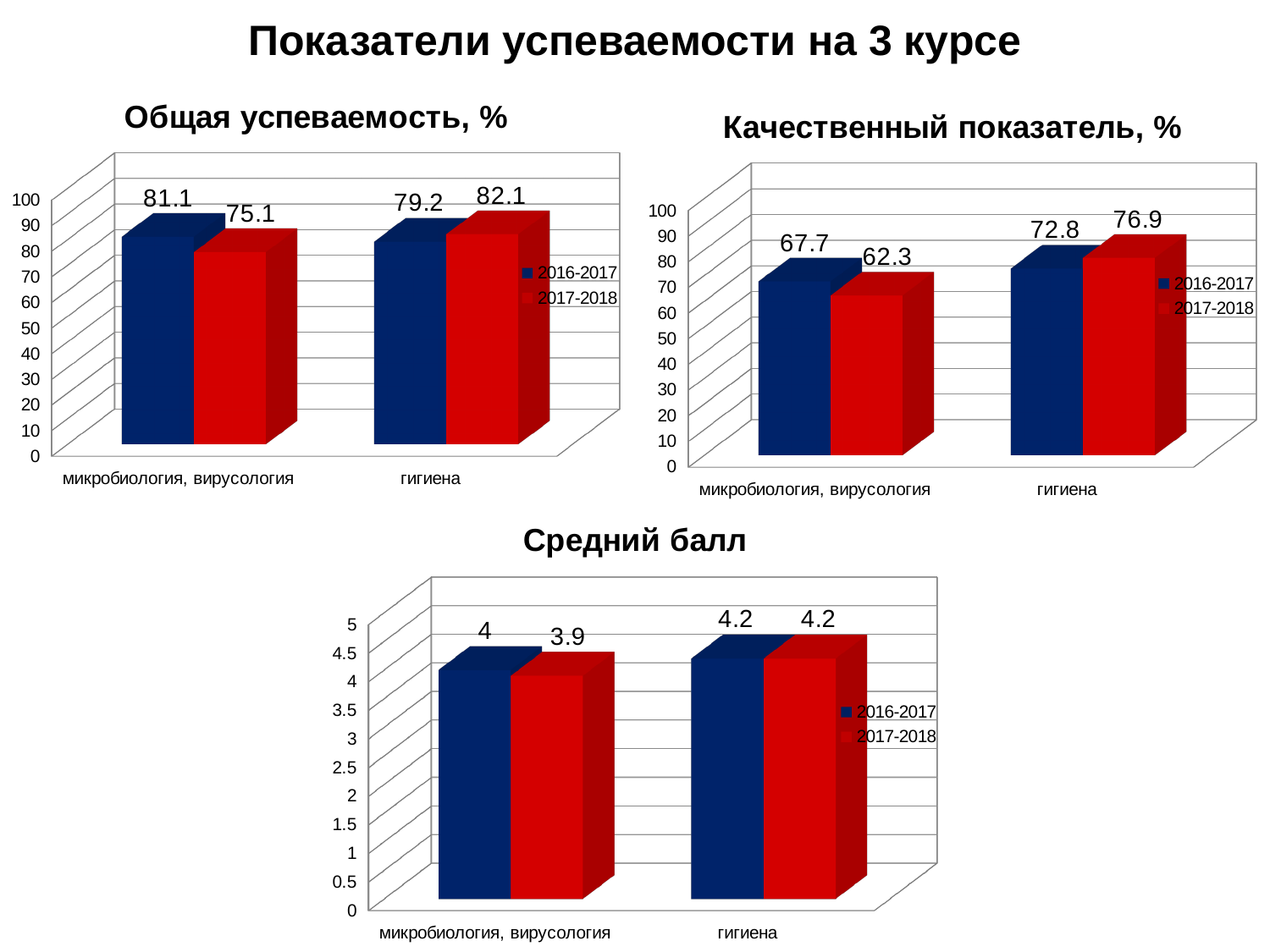
In the chart titled "Средний балл", what is the value for гигиена in 2016-2017? 4.2 In the chart titled "Общая успеваемость, %", what is the value for микробиология, вирусология in 2016-2017? 81.1 In the chart titled "Качественный показатель, %", which is larger for гигиена: the 2016-2017 value or the 2017-2018 value? 2017-2018 In the chart titled "Средний балл", how many series does the legend list? 2 In the chart titled "Общая успеваемость, %", how many categories are shown on the x axis? 2 In the chart titled "Общая успеваемость, %", what is the value for гигиена in 2017-2018? 82.1 What kind of chart is the chart titled "Средний балл"? bar chart In the chart titled "Качественный показатель, %", which category has the highest value in 2016-2017? гигиена In the chart titled "Качественный показатель, %", what is the value for микробиология, вирусология in 2017-2018? 62.3 In the chart titled "Качественный показатель, %", what is the difference between the 2017-2018 and 2016-2017 values for гигиена? 4.1 In the chart titled "Общая успеваемость, %", what is the difference between the 2016-2017 and 2017-2018 values for микробиология, вирусология? 6 In the chart titled "Средний балл", what is the value for микробиология, вирусология in 2017-2018? 3.9